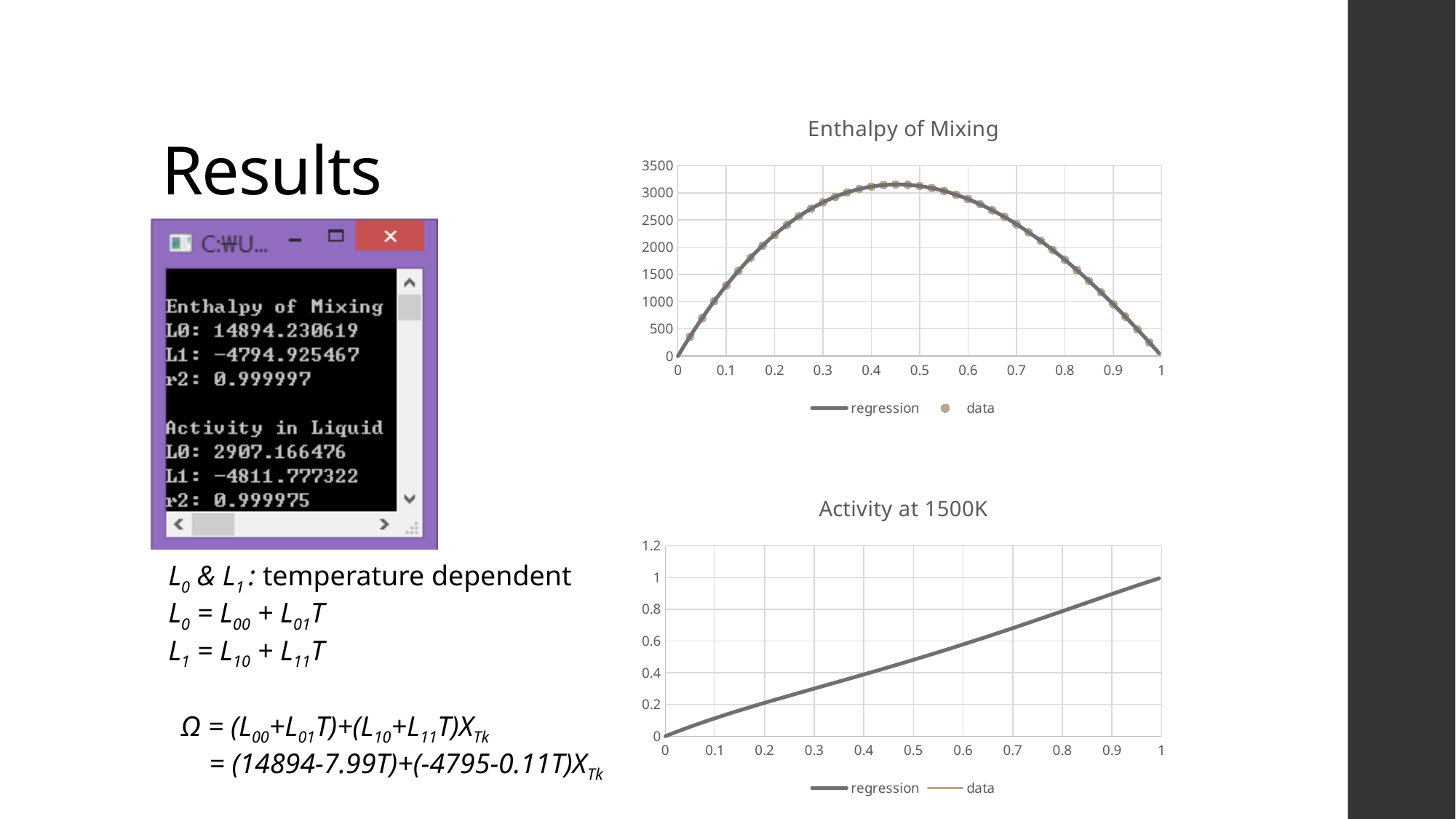
In the Activity at 1500K chart, do the values rise or fall as x increases from 0 to 1? rise In the Enthalpy of Mixing chart, is the value at x = 0.3 greater or less than 2500? greater In the Activity at 1500K chart, how many series does the legend list? 2 What kind of chart is the Activity at 1500K chart? line chart In the Enthalpy of Mixing chart, what is the highest value shown on the y axis? 3500 In the Activity at 1500K chart, is the value at x = 0.8 greater or less than 1? less In the Enthalpy of Mixing chart, how many series does the legend list? 2 In the Activity at 1500K chart, is the value at x = 0.5 greater or less than 0.6? less What is the title of the bottom chart? Activity at 1500K What is the title of the top chart? Enthalpy of Mixing